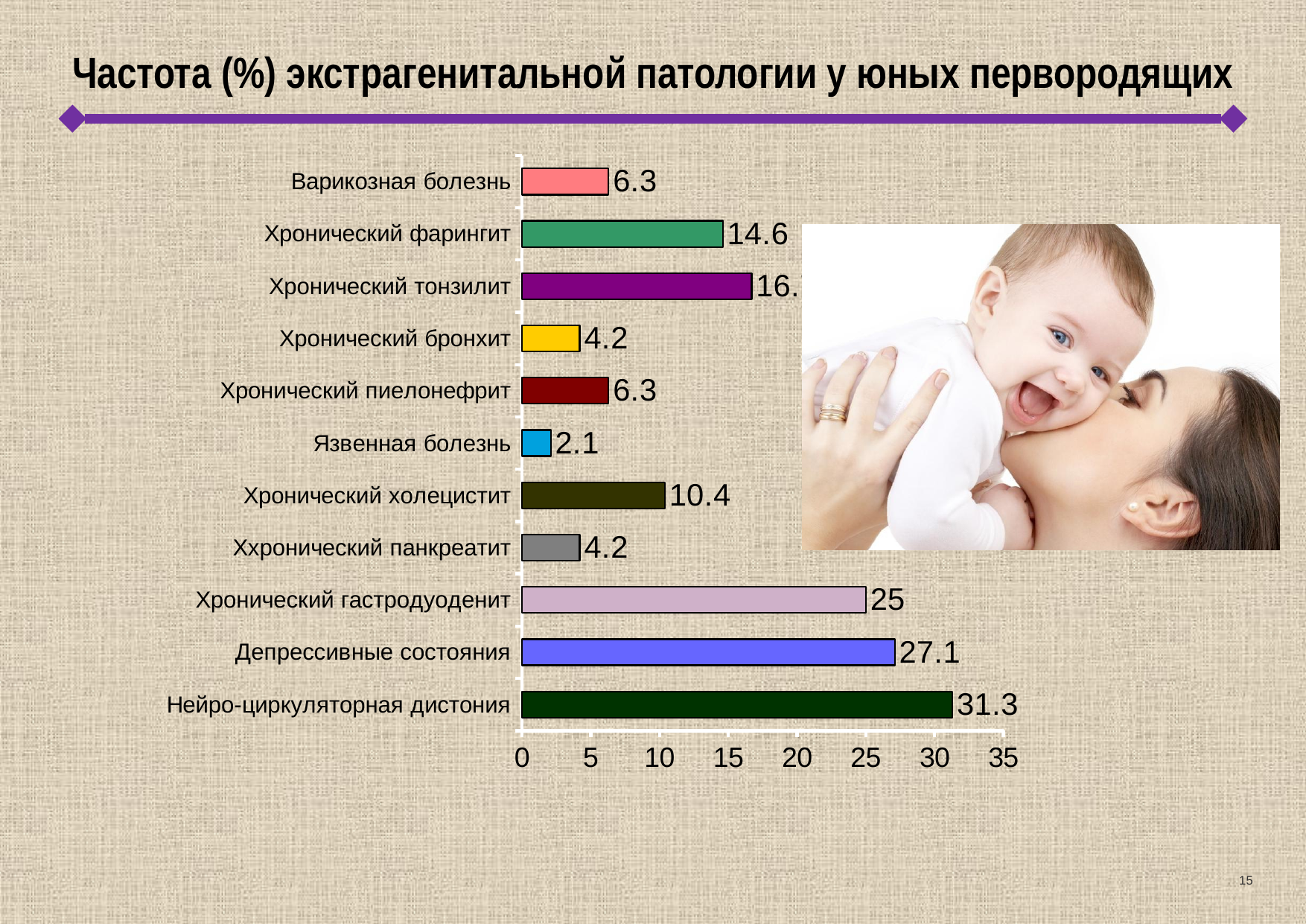
Which category has the highest value? Нейро-циркуляторная дистония Is the value for Хронический тонзилит greater or less than 20? less What is the title of the slide? Частота (%) экстрагенитальной патологии у юных первородящих Which category has the lowest value? Язвенная болезнь What is the value for Депрессивные состояния? 27.1 What is the difference between the values for Нейро-циркуляторная дистония and Депрессивные состояния? 4.2 What is the value for Язвенная болезнь? 2.1 What is the value for Хронический холецистит? 10.4 What is the value for Нейро-циркуляторная дистония? 31.3 Which is larger, the value for Хронический фарингит or the value for Хронический холецистит? Хронический фарингит What kind of chart is shown on the slide? bar chart How many categories are shown in the chart? 11